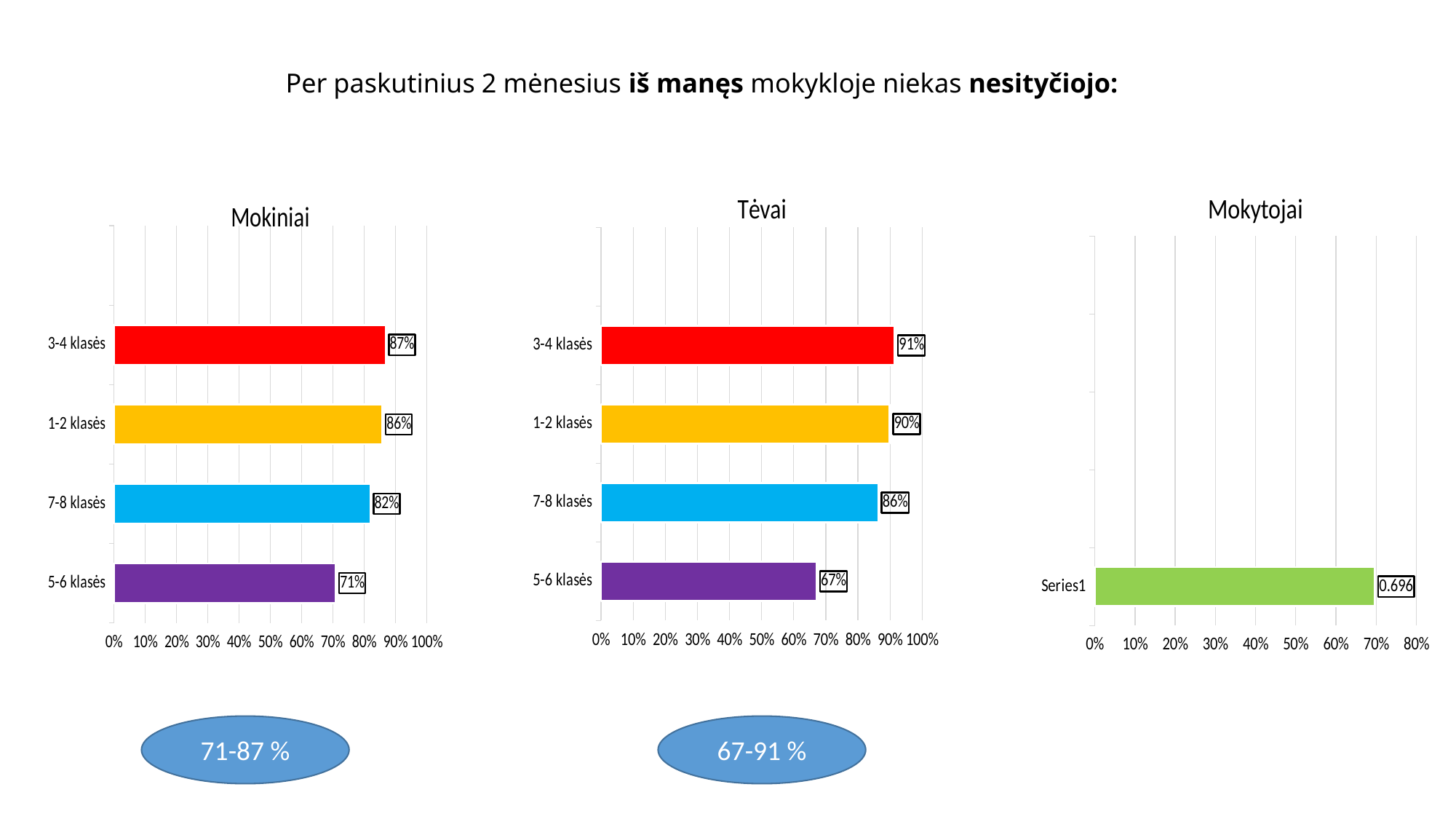
What is the title of the chart on the right of the slide? Mokytojai In the Tėvai chart, what is the value for 7-8 klasės? 86% How many categories does the Tėvai chart show? 4 In the Mokytojai chart, is the value for Series1 greater or less than 60%? greater In the Tėvai chart, what is the difference between the values for 3-4 klasės and 5-6 klasės? 24% In the Mokiniai chart, which category has the lowest value? 5-6 klasės In the Tėvai chart, which category has the highest value? 3-4 klasės In the Mokytojai chart, what is the value for Series1? 0.696 In the Mokiniai chart, what is the value for 5-6 klasės? 71% In the Mokiniai chart, which is larger, the value for 7-8 klasės or the value for 5-6 klasės? 7-8 klasės What kind of chart is the Mokiniai chart? bar chart In the Mokiniai chart, what is the value for 3-4 klasės? 87%